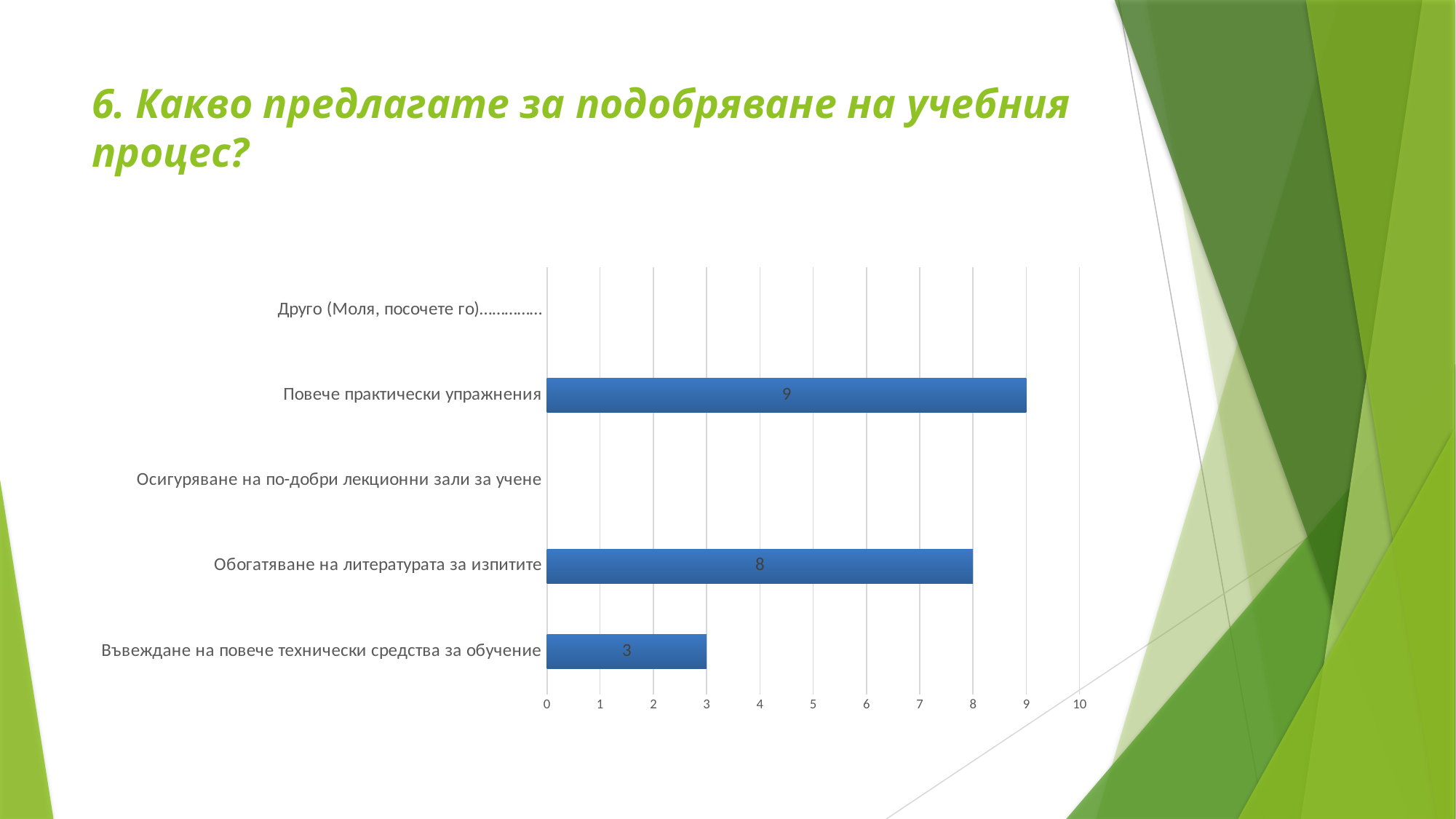
What is the title of the slide? 6. Какво предлагате за подобряване на учебния процес? Is the value for "Въвеждане на повече технически средства за обучение" greater or less than 5? less What is the value for "Повече практически упражнения"? 9 What is the difference between the values for "Повече практически упражнения" and "Въвеждане на повече технически средства за обучение"? 6 Is the value for "Повече практически упражнения" greater or less than 5? greater Which is larger: the value for "Обогатяване на литературата за изпитите" or the value for "Въвеждане на повече технически средства за обучение"? Обогатяване на литературата за изпитите What kind of chart is shown on the slide? bar chart What is the value for "Въвеждане на повече технически средства за обучение"? 3 What is the difference between the values for "Обогатяване на литературата за изпитите" and "Въвеждане на повече технически средства за обучение"? 5 Which category has the highest value? Повече практически упражнения How many categories are shown on the chart's vertical axis? 5 What is the value for "Обогатяване на литературата за изпитите"? 8